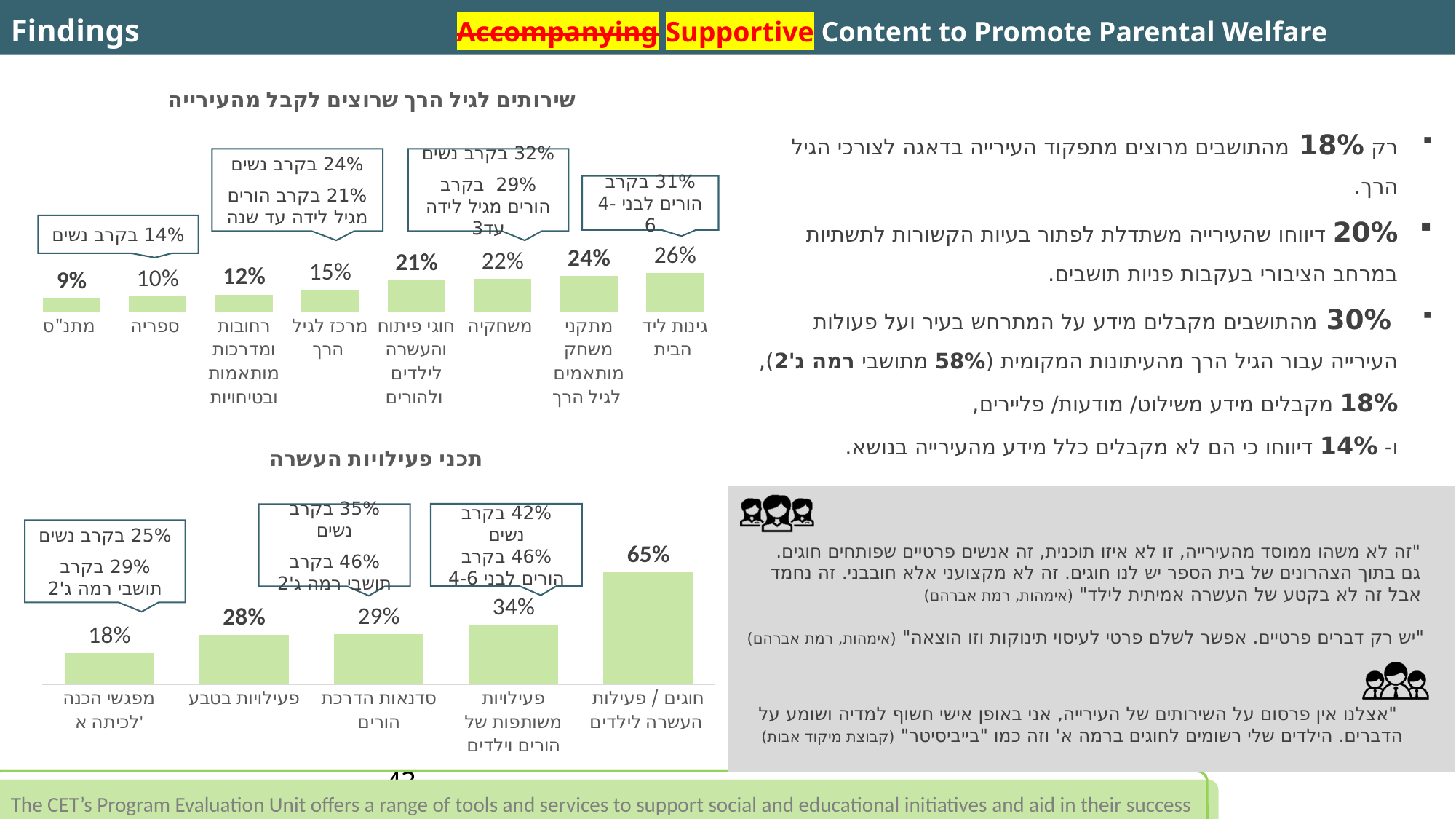
In the top chart (שירותים לגיל הרך שרוצים לקבל מהעירייה), what is the difference between the values for גינות ליד הבית and ספריה? 16% In the top chart (שירותים לגיל הרך שרוצים לקבל מהעירייה), what is the value for משחקיה? 22% In the bottom chart (תכני פעילויות העשרה), what is the value for חוגים / פעילות העשרה לילדים? 65% What type of chart is the bottom chart (תכני פעילויות העשרה)? Bar chart In the top chart (שירותים לגיל הרך שרוצים לקבל מהעירייה), which category has the lowest value? מתנ"ס In the bottom chart (תכני פעילויות העשרה), which category has the lowest value? מפגשי הכנה לכיתה א' In the bottom chart (תכני פעילויות העשרה), what is the difference between the values for חוגים / פעילות העשרה לילדים and מפגשי הכנה לכיתה א'? 47% In the bottom chart (תכני פעילויות העשרה), what is the value for סדנאות הדרכת הורים? 29% In the bottom chart (תכני פעילויות העשרה), which is larger: פעילויות משותפות של הורים וילדים or פעילויות בטבע? פעילויות משותפות של הורים וילדים In the top chart (שירותים לגיל הרך שרוצים לקבל מהעירייה), what is the value for גינות ליד הבית? 26% In the top chart (שירותים לגיל הרך שרוצים לקבל מהעירייה), how many categories are shown? 8 In the top chart (שירותים לגיל הרך שרוצים לקבל מהעירייה), which category has the highest value? גינות ליד הבית